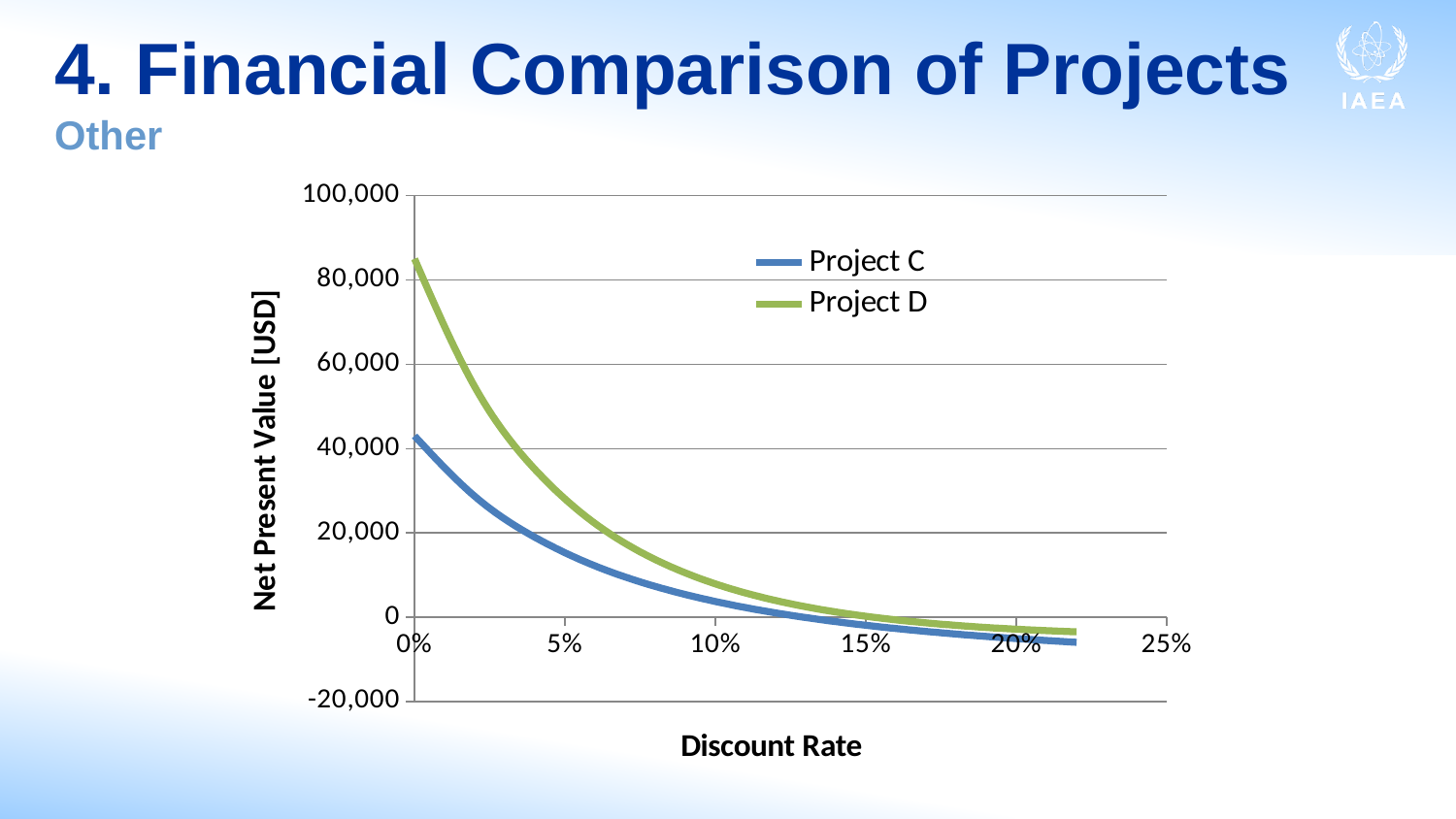
Is the Net Present Value for Project C at a 5% discount rate greater or less than 20,000? less Do the Net Present Values of Project D rise or fall as the discount rate increases? fall Which series has the higher Net Present Value at a 5% discount rate, Project C or Project D? Project D Which series has the higher Net Present Value at a 0% discount rate, Project C or Project D? Project D What kind of chart is shown on the slide? line chart Is the Net Present Value for Project C at a 0% discount rate greater or less than 60,000? less Is the Net Present Value for Project D at a 0% discount rate greater or less than 60,000? greater Do the Net Present Values of Project C rise or fall as the discount rate increases? fall What is the title of the x axis of the chart? Discount Rate How many series does the legend list? 2